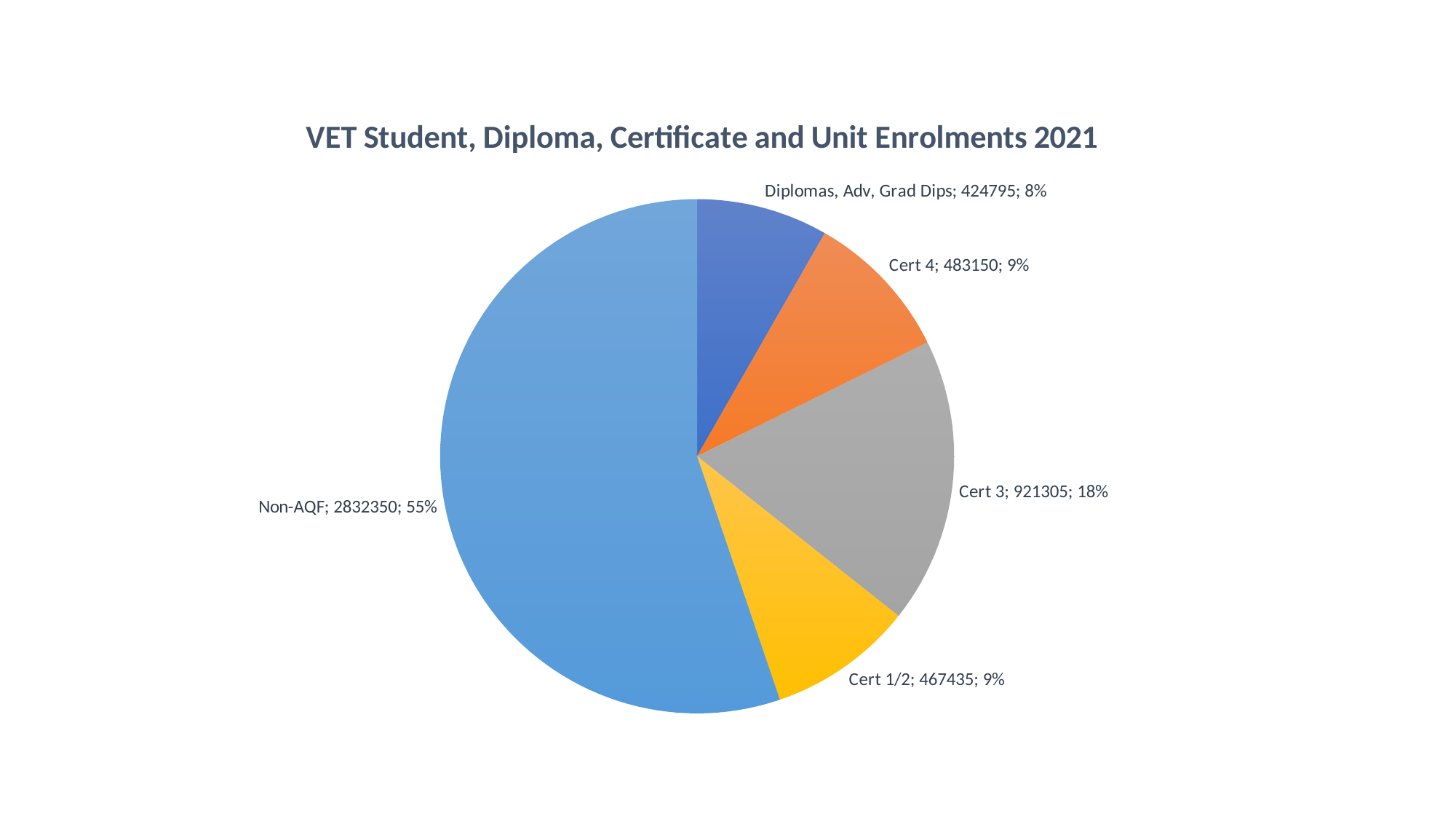
What kind of chart is shown on the slide? pie chart What is the title of the chart? VET Student, Diploma, Certificate and Unit Enrolments 2021 What share of the pie does Cert 1/2 represent? 9% What is the value for Cert 3? 921305 Which category has the largest slice? Non-AQF What is the value for Non-AQF? 2832350 What share of the pie does Non-AQF represent? 55% Which category has the smallest slice? Diplomas, Adv, Grad Dips What is the difference between the values for Cert 3 and Cert 4? 438155 What is the value for Diplomas, Adv, Grad Dips? 424795 What is the value for Cert 4? 483150 How many slices does the pie chart have? 5